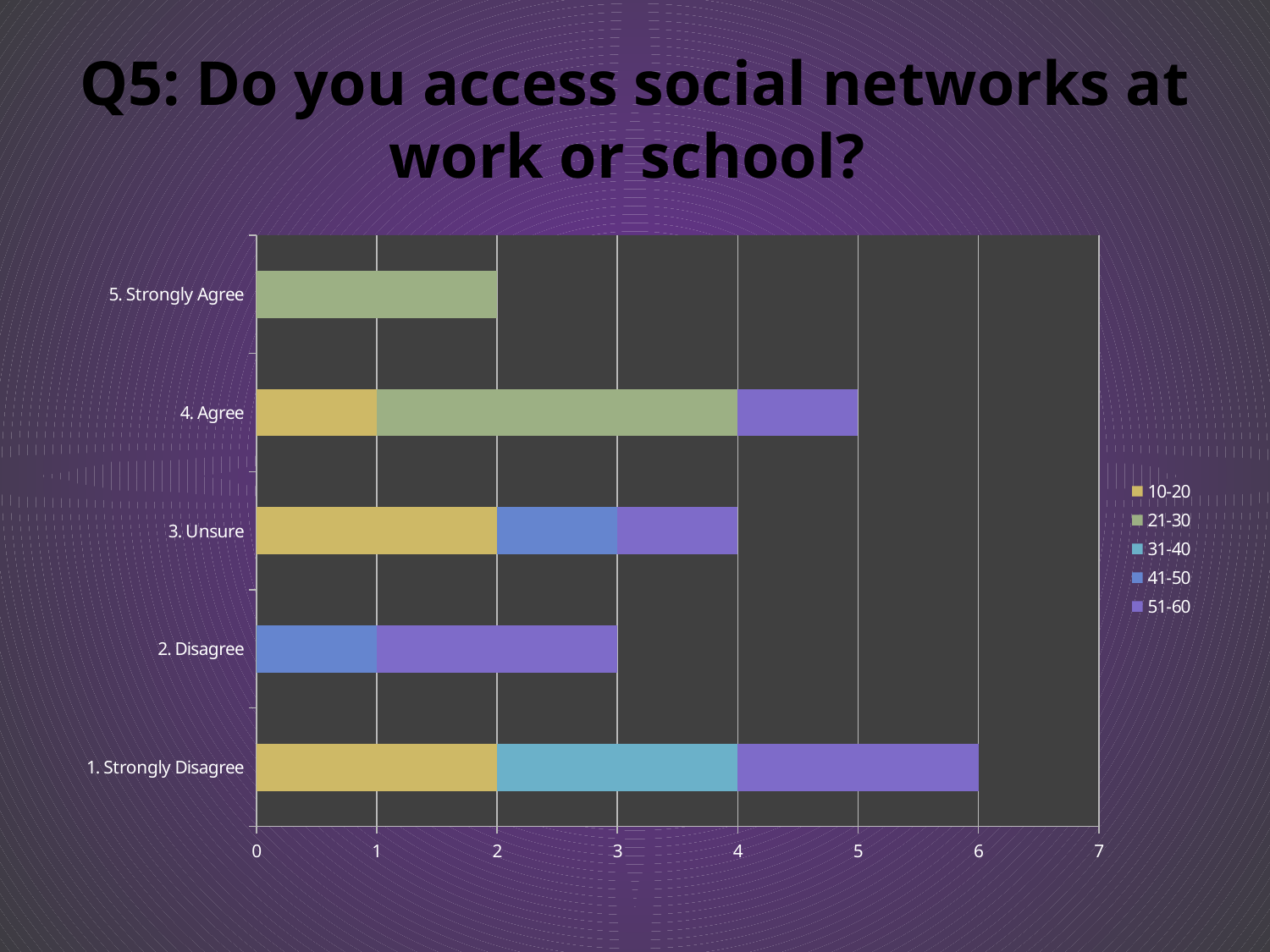
Which response category has the longest stacked bar overall? 1. Strongly Disagree What is the total length of the stacked bar for '2. Disagree'? 3 What is the total length of the stacked bar for '1. Strongly Disagree'? 6 What is the difference between the total bar for '1. Strongly Disagree' and the total bar for '5. Strongly Agree'? 4 What is the total length of the stacked bar for '4. Agree'? 5 How many series does the legend list? 5 Which response category has the shortest stacked bar overall? 5. Strongly Agree What is the value of the 31-40 series for '1. Strongly Disagree'? 2 What is the value of the 21-30 series for '4. Agree'? 3 What kind of chart is shown on the slide? Stacked bar chart Which has a longer total bar, '3. Unsure' or '2. Disagree'? 3. Unsure How many response categories are shown on the vertical axis? 5